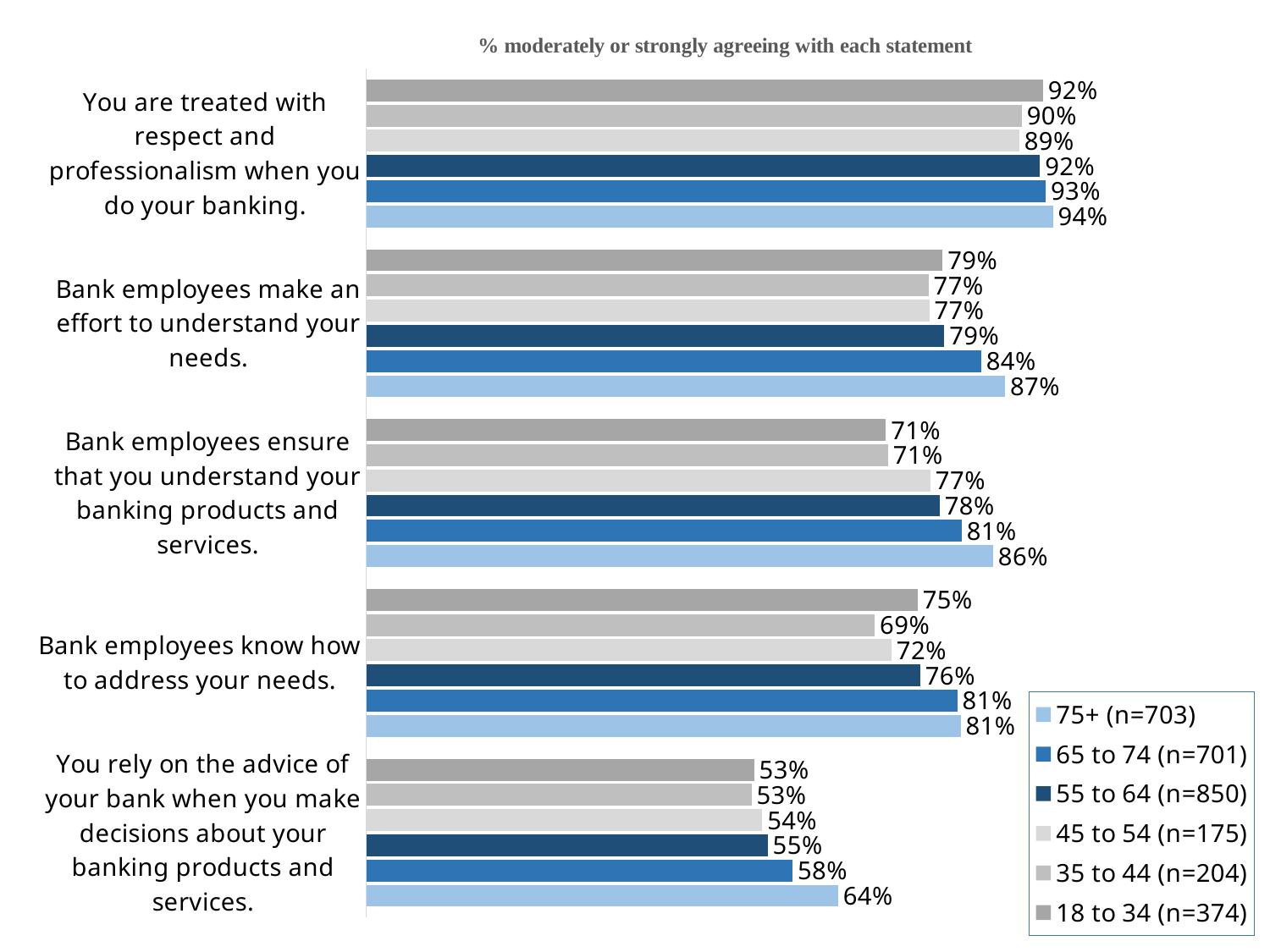
What percentage of respondents aged 75+ agree that they are treated with respect and professionalism when they do their banking? 94% What type of chart is shown on the slide? Bar chart For the statement that bank employees make an effort to understand your needs, which group has the higher value: 75+ or 55 to 64? 75+ What percentage of respondents aged 65 to 74 agree that bank employees make an effort to understand their needs? 84% How many statements are shown on the chart? 5 What percentage of respondents aged 18 to 34 agree that they rely on the advice of their bank when making decisions about banking products and services? 53% Which age group has the highest agreement that bank employees ensure they understand their banking products and services? 75+ What is the difference between the 75+ group and the 18 to 34 group in agreeing that they rely on the advice of their bank? 11 percentage points Which age group has the lowest agreement that bank employees know how to address their needs? 35 to 44 How many age groups does the legend list? 6 What is the sample size for the 55 to 64 age group shown in the legend? n=850 What percentage of respondents aged 35 to 44 agree that bank employees know how to address their needs? 69%